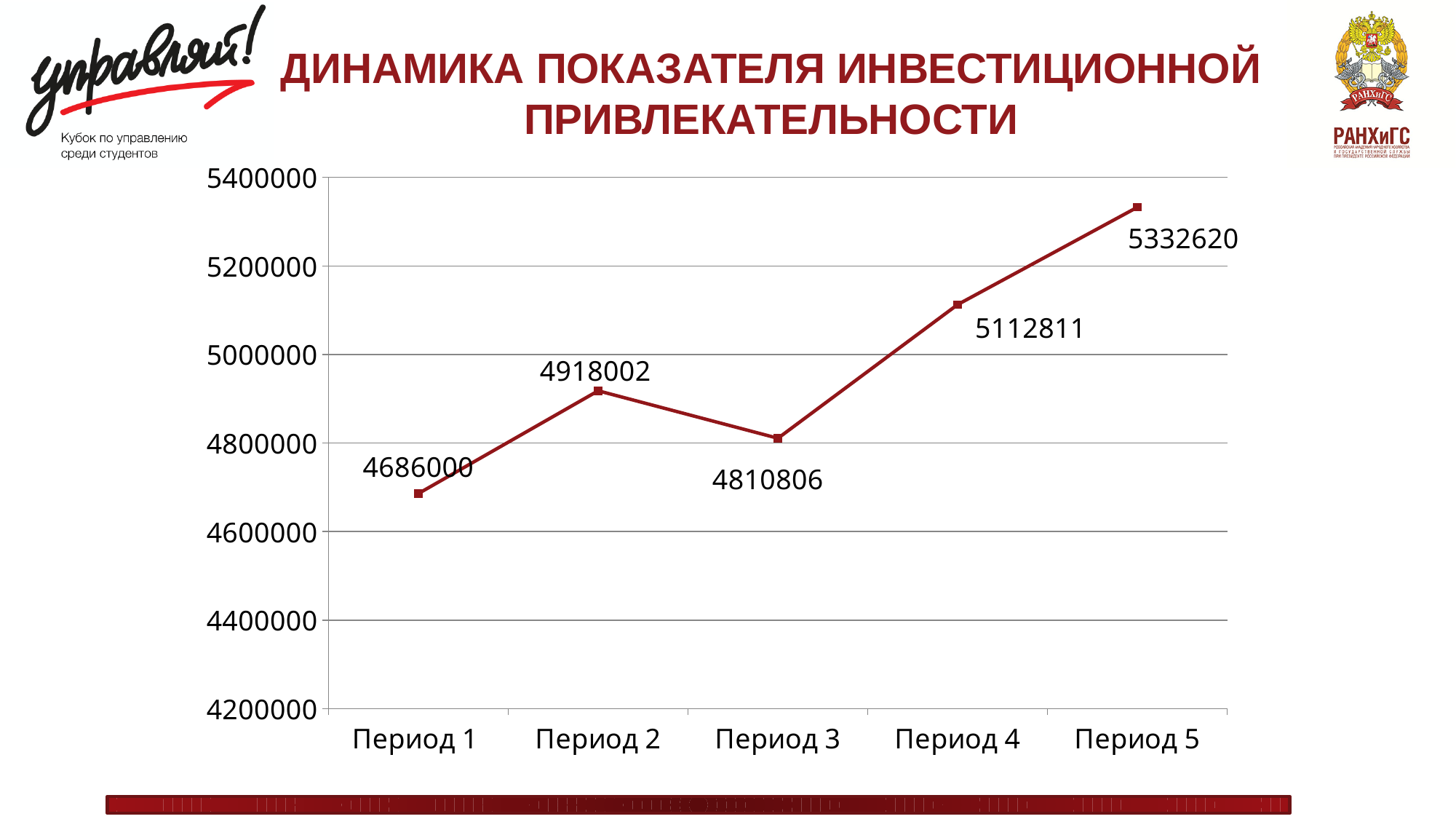
What is the value for Период 1? 4686000 What is the value for Период 3? 4810806 How many periods are plotted on the chart? 5 What kind of chart is shown on the slide? line chart What is the value for Период 5? 5332620 What is the difference between the values for Период 2 and Период 3? 107196 Does the value rise or fall from Период 2 to Период 3? fall Which period has the highest value? Период 5 What is the difference between the values for Период 5 and Период 1? 646620 Which period has the lowest value? Период 1 Which is larger, the value for Период 2 or the value for Период 3? Период 2 Is the value for Период 4 greater or less than 5000000? greater